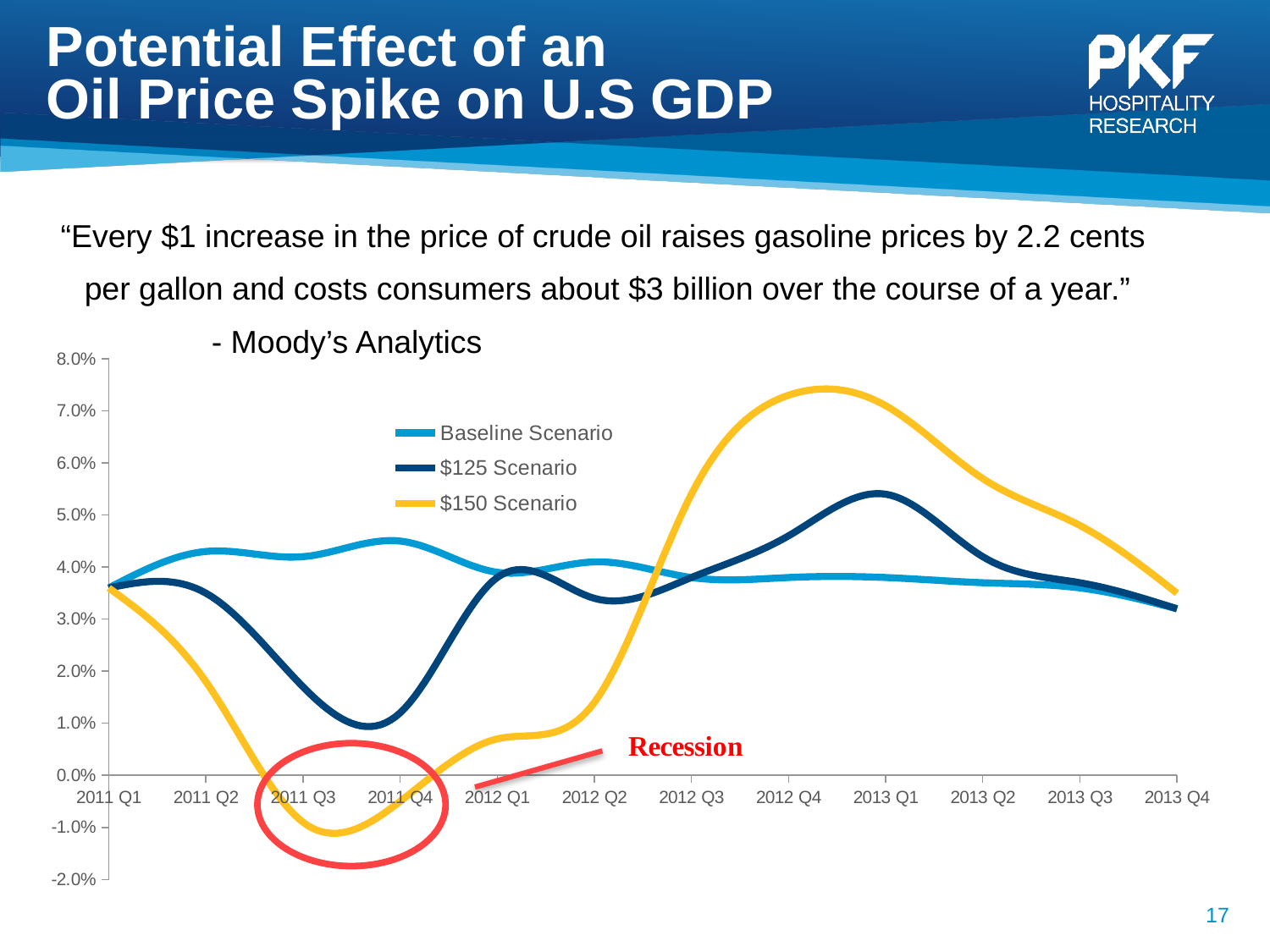
How many quarters are shown along the x axis of the chart? 12 At 2011 Q3, which series has the higher value: the Baseline Scenario or the $150 Scenario? Baseline Scenario How many series does the chart's legend list? 3 What kind of chart is shown on the slide? Line chart Which series reaches the highest value anywhere on the chart? $150 Scenario Is the value of the $150 Scenario at 2012 Q4 greater or less than 7.0%? greater Is the value of the Baseline Scenario at 2013 Q4 greater or less than 4.0%? less Is the value of the $125 Scenario at 2013 Q1 greater or less than 5.0%? greater What word is written in red next to the circled dip in the chart? Recession Does the $150 Scenario rise or fall from 2012 Q4 to 2013 Q4? Fall At 2012 Q4, which series has the higher value: the $150 Scenario or the Baseline Scenario? $150 Scenario